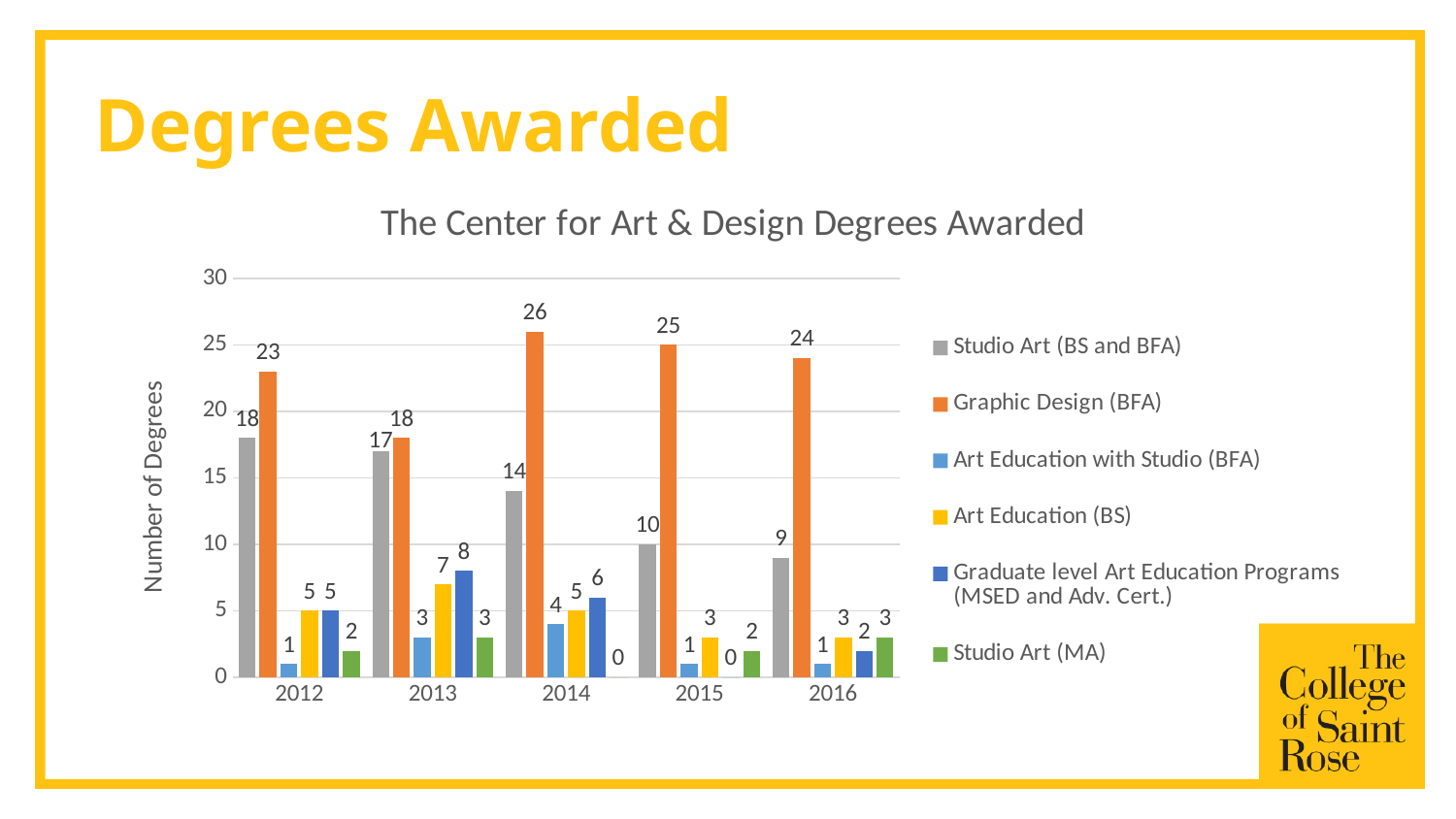
What is the difference between Graphic Design (BFA) and Studio Art (BS and BFA) degrees in 2015? 15 How many Art Education (BS) degrees were awarded in 2013? 7 How many Graphic Design (BFA) degrees were awarded in 2014? 26 Which was larger in 2012: Studio Art (BS and BFA) or Graphic Design (BFA)? Graphic Design (BFA) Do the Studio Art (BS and BFA) values rise or fall from 2012 to 2016? Fall How many Studio Art (BS and BFA) degrees were awarded in 2016? 9 How many years are shown on the x axis? 5 In which year was the number of Studio Art (BS and BFA) degrees lowest? 2016 In which year was the number of Graphic Design (BFA) degrees highest? 2014 What is the label of the y axis? Number of Degrees How many series does the legend list? 6 What kind of chart is shown? Bar chart